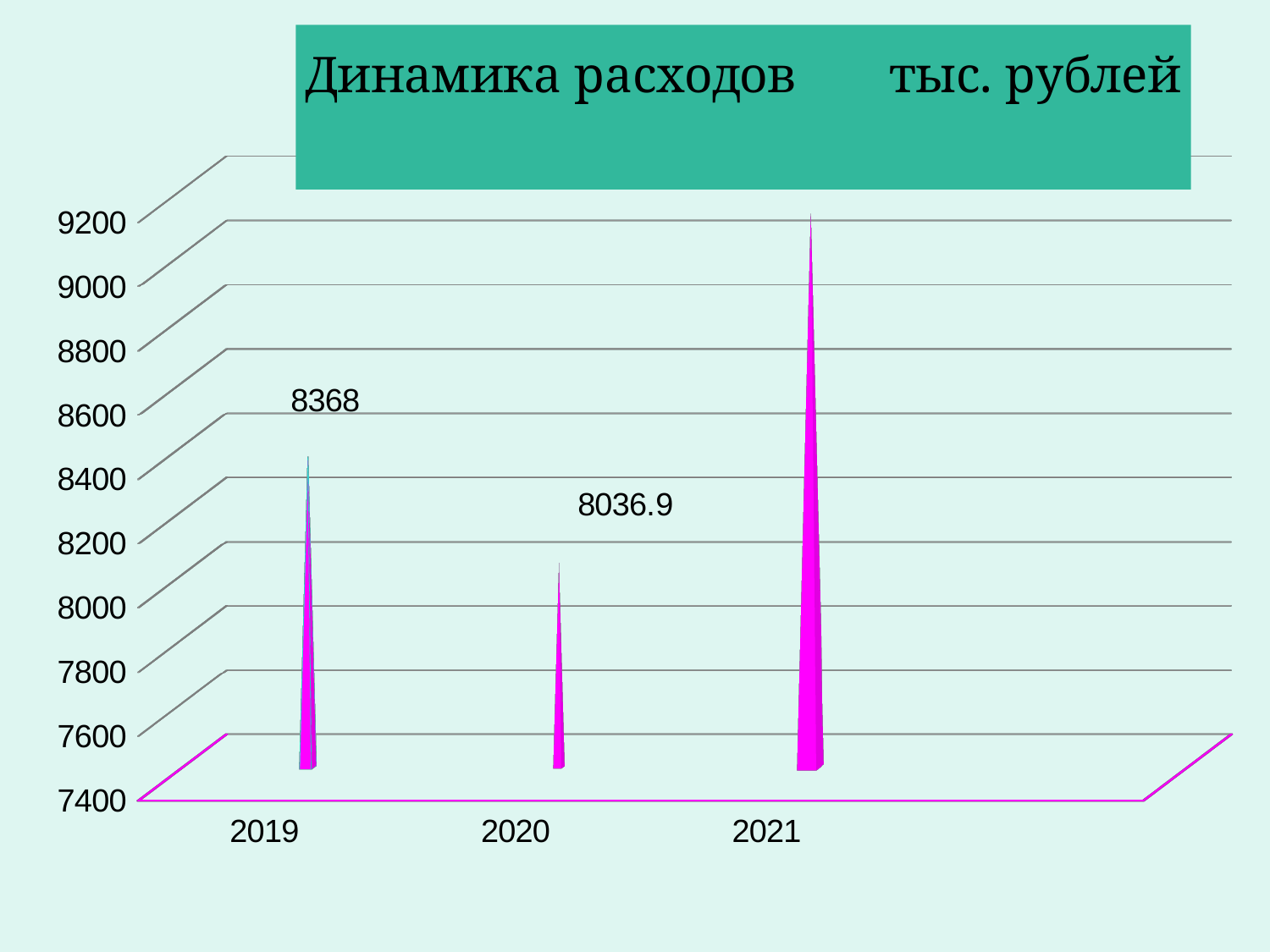
What kind of chart is shown on the slide? bar chart Which is larger, the value for 2019 or the value for 2020? 2019 Is the value for 2021 greater or less than 9000? greater What is the value for 2019? 8368 What is the difference between the values for 2019 and 2020? 331.1 Which year has the lowest value? 2020 Which year has the highest value? 2021 What is the title of the chart? Динамика расходов тыс. рублей Does the value rise or fall from 2020 to 2021? rise Is the value for 2020 greater or less than 8200? less What is the value for 2020? 8036.9 How many years are shown on the x axis? 3